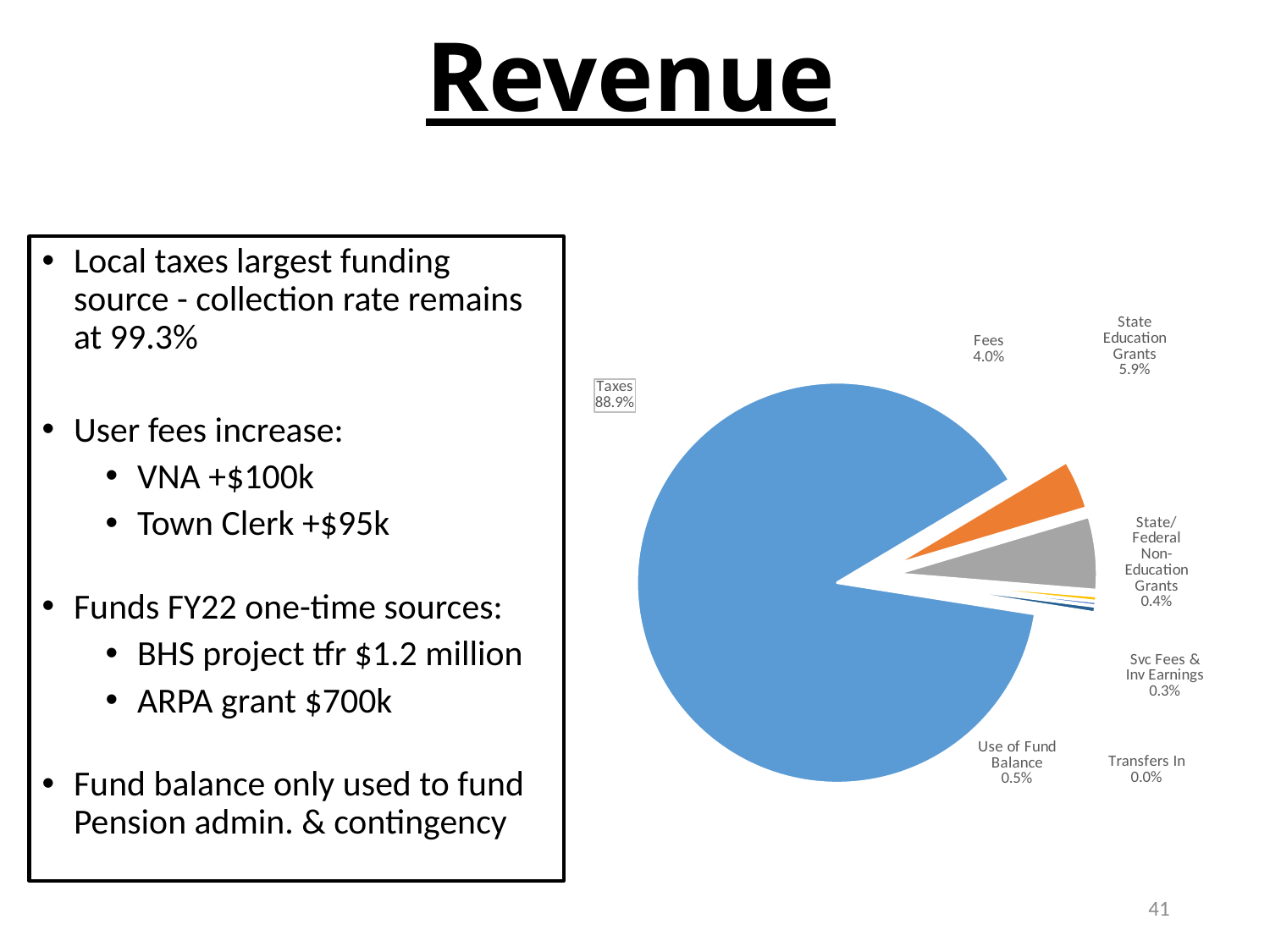
What kind of chart is shown on the slide? pie chart What is the value shown for Fees? 4.0% What is the value shown for Svc Fees & Inv Earnings? 0.3% What is the difference between the State Education Grants share and the Fees share? 1.9% What share of the pie does Taxes represent? 88.9% How many categories are shown in the pie chart? 7 What is the value shown for State Education Grants? 5.9% Which category has the smallest share of the pie? Transfers In Which category has the largest slice of the pie? Taxes What is the value shown for Use of Fund Balance? 0.5% What is the value shown for Transfers In? 0.0% Which is larger, State Education Grants or Fees? State Education Grants